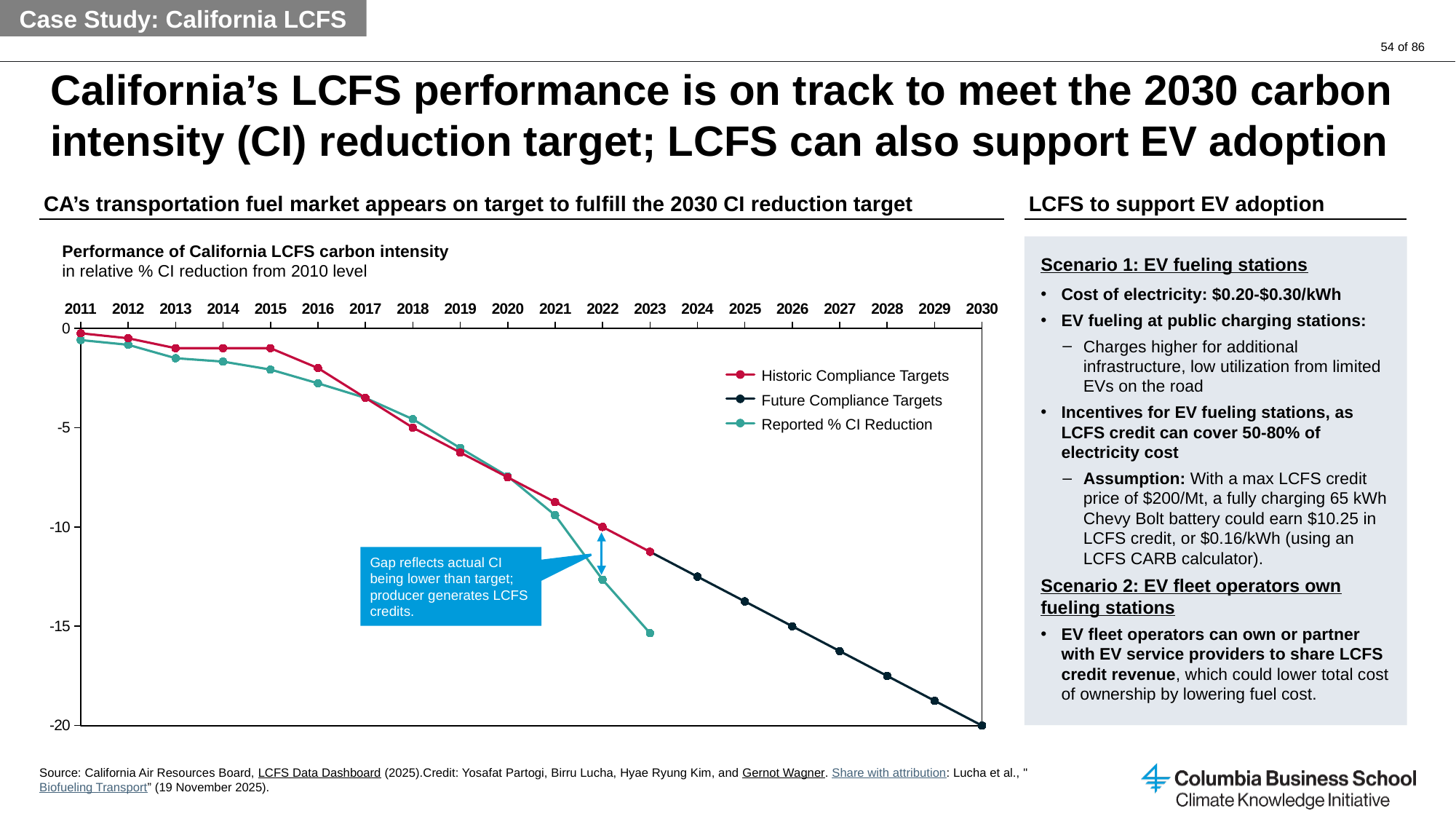
Is the Reported % CI Reduction value for 2023 greater or less than -15? less Is the Reported % CI Reduction value for 2022 greater or less than -10? less What is the title of the chart? Performance of California LCFS carbon intensity Is the Future Compliance Target value for 2027 greater or less than -15? less What is the Future Compliance Target value for 2030? -20 How many series does the chart legend list? 3 Which year has the lowest value on the chart? 2030 In 2023, which is larger: the Historic Compliance Target or the Reported % CI Reduction? Historic Compliance Target How many years are shown along the x axis of the chart? 20 What kind of chart is shown on the slide? Line chart Do the plotted values rise or fall from 2011 to 2030? Fall